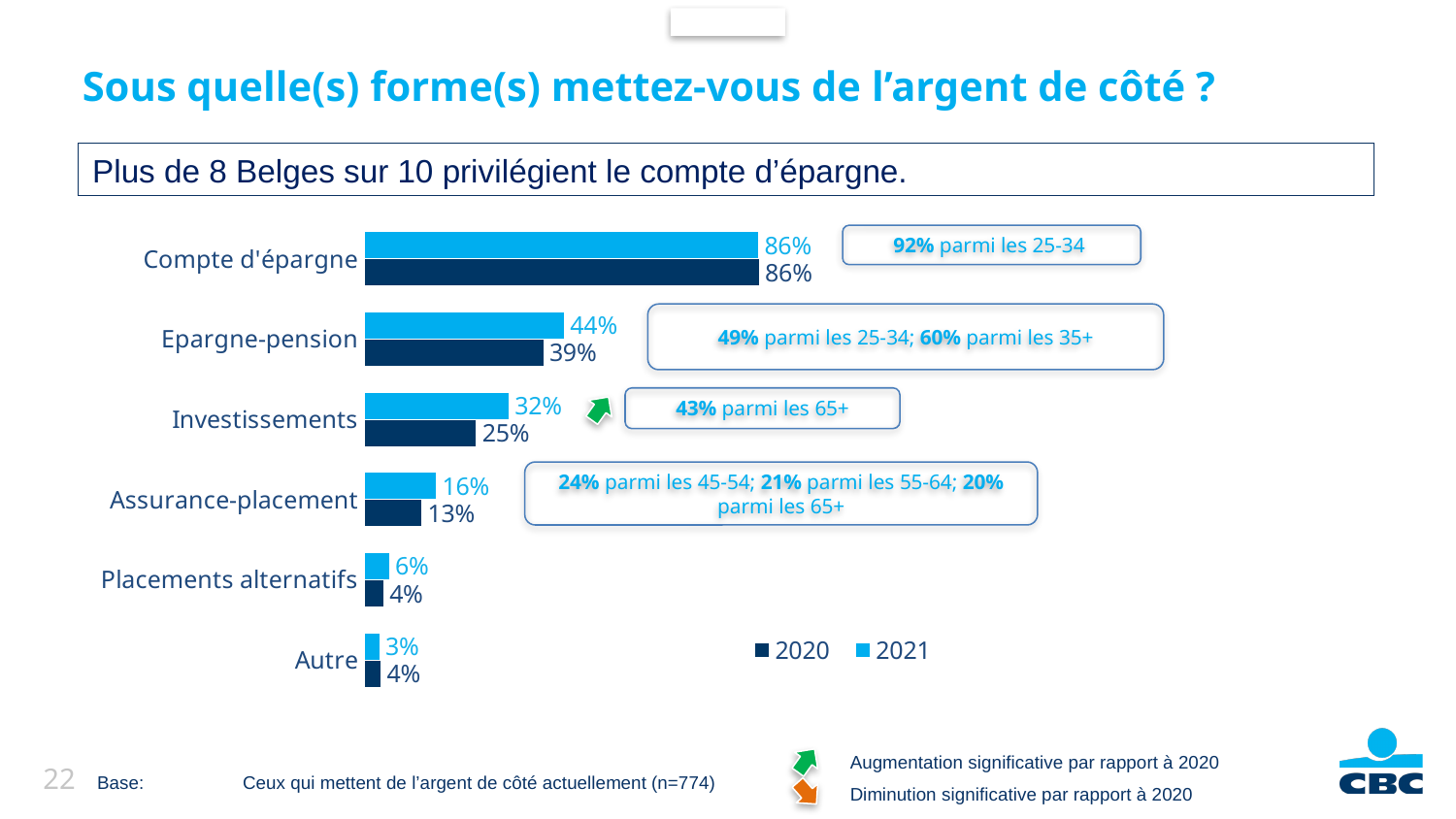
How many series does the legend list? 2 What is the 2020 value for Autre? 4% Which category has the highest 2021 value? Compte d'épargne What is the 2021 value for Assurance-placement? 16% What is the difference between the 2021 and 2020 values for Investissements? 7% What kind of chart is shown on the slide? Bar chart What is the 2021 value for Epargne-pension? 44% Which category has the lowest 2021 value? Autre What is the 2020 value for Investissements? 25% How many categories are shown in the chart? 6 Which is larger for Placements alternatifs, the 2020 value or the 2021 value? 2021 What is the difference between the 2021 and 2020 values for Epargne-pension? 5%